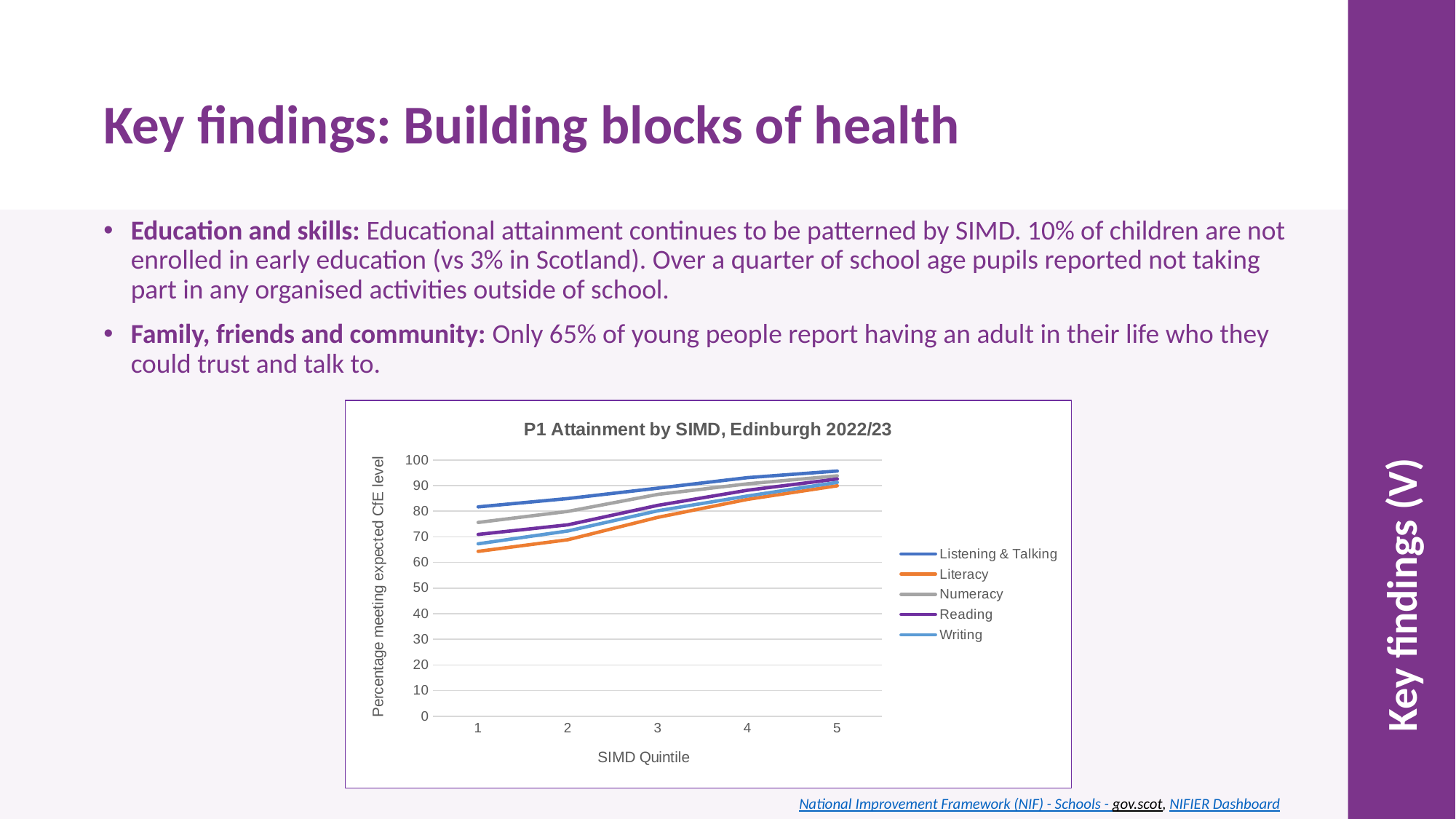
Which series has the lowest value at SIMD quintile 1? Literacy What is the title of the chart? P1 Attainment by SIMD, Edinburgh 2022/23 How many SIMD quintiles are plotted along the x axis of the chart? 5 At SIMD quintile 1, which is larger: the value for Numeracy or the value for Writing? Numeracy Do the values for Literacy rise or fall as the SIMD quintile increases from 1 to 5? Rise How many series does the legend of the chart list? 5 Is the value for Listening & Talking at SIMD quintile 1 greater or less than 80? greater Is the value for Literacy at SIMD quintile 1 greater or less than 70? less Is the value for Numeracy at SIMD quintile 5 greater or less than 90? greater What is the label of the y axis of the chart? Percentage meeting expected CfE level What kind of chart is shown on the slide? Line chart Which series has the highest value at SIMD quintile 1? Listening & Talking